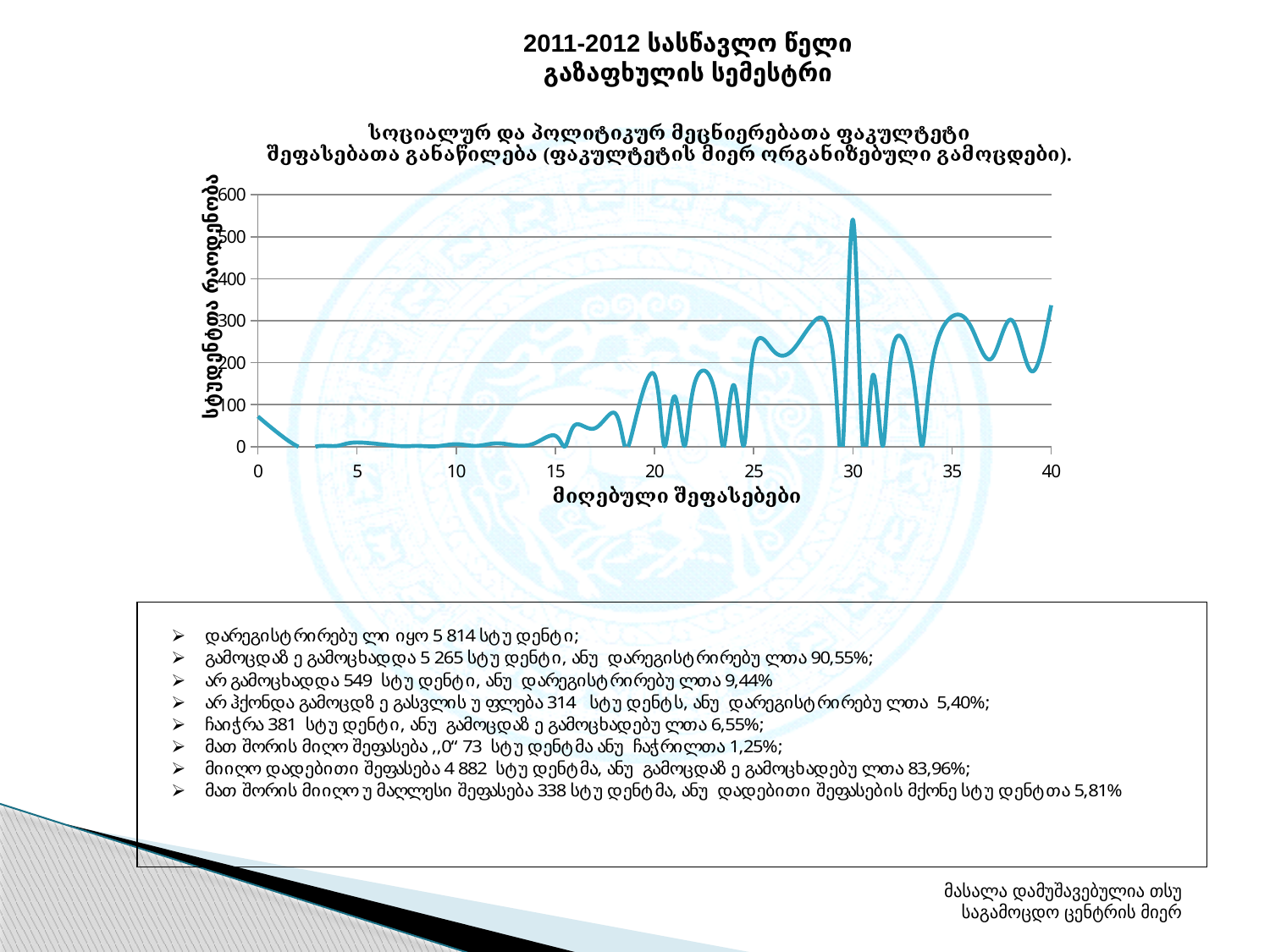
What is the highest tick value shown on the y axis? 600 Is the value of the line at x = 10 greater or less than 100? less What kind of chart is shown on the slide? line chart Which is larger, the value of the line at x = 5 or at x = 35? x = 35 Overall, do the values of the line rise or fall as the x axis goes from 0 to 40? rise At which value on the x axis does the line reach its highest point? 30 Is the value of the line at x = 25 greater or less than 200? greater Is the value of the line at x = 40 greater or less than 300? greater What is the highest tick value shown on the x axis? 40